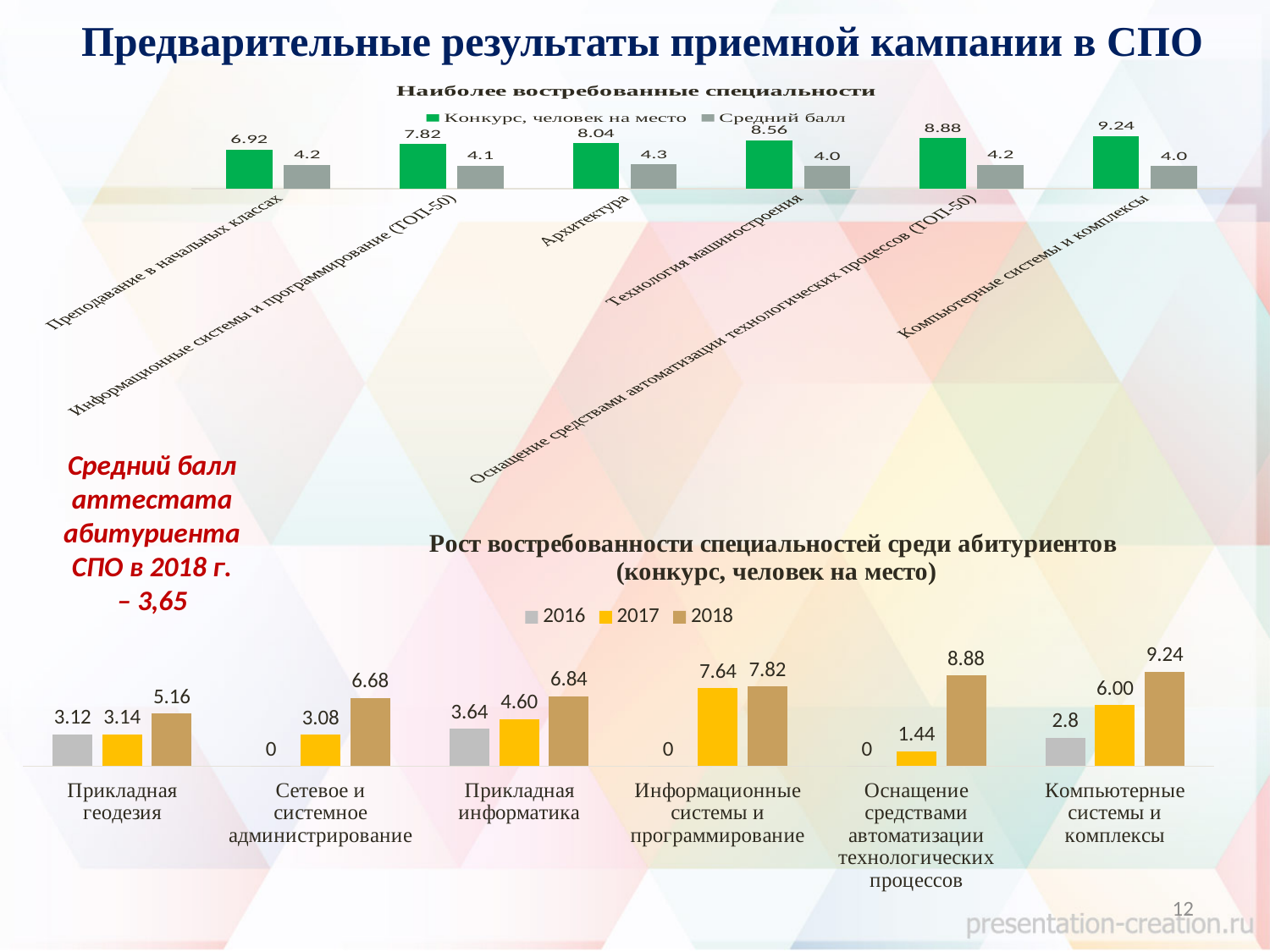
In the bottom chart 'Рост востребованности специальностей среди абитуриентов', which is larger for Прикладная информатика: the 2017 value or the 2018 value? 2018 In the top chart 'Наиболее востребованные специальности', which specialty has the highest 'Конкурс, человек на место'? Компьютерные системы и комплексы In the top chart 'Наиболее востребованные специальности', which specialty has the lowest 'Конкурс, человек на место'? Преподавание в начальных классах In the bottom chart 'Рост востребованности специальностей среди абитуриентов', do the values for Компьютерные системы и комплексы rise or fall from 2016 to 2018? rise In the top chart 'Наиболее востребованные специальности', how many series does the legend list? 2 In the top chart 'Наиболее востребованные специальности', what is the value of 'Конкурс, человек на место' for Архитектура? 8.04 In the bottom chart 'Рост востребованности специальностей среди абитуриентов', how many categories are shown on the x axis? 6 In the bottom chart 'Рост востребованности специальностей среди абитуриентов', what is the 2018 value for Прикладная геодезия? 5.16 What type of chart is the bottom chart 'Рост востребованности специальностей среди абитуриентов'? bar chart In the top chart 'Наиболее востребованные специальности', what is the difference between the 'Конкурс, человек на место' values for Компьютерные системы и комплексы and Преподавание в начальных классах? 2.32 In the top chart 'Наиболее востребованные специальности', what is the 'Средний балл' for Технология машиностроения? 4.0 In the bottom chart 'Рост востребованности специальностей среди абитуриентов', what is the 2017 value for Оснащение средствами автоматизации технологических процессов? 1.44